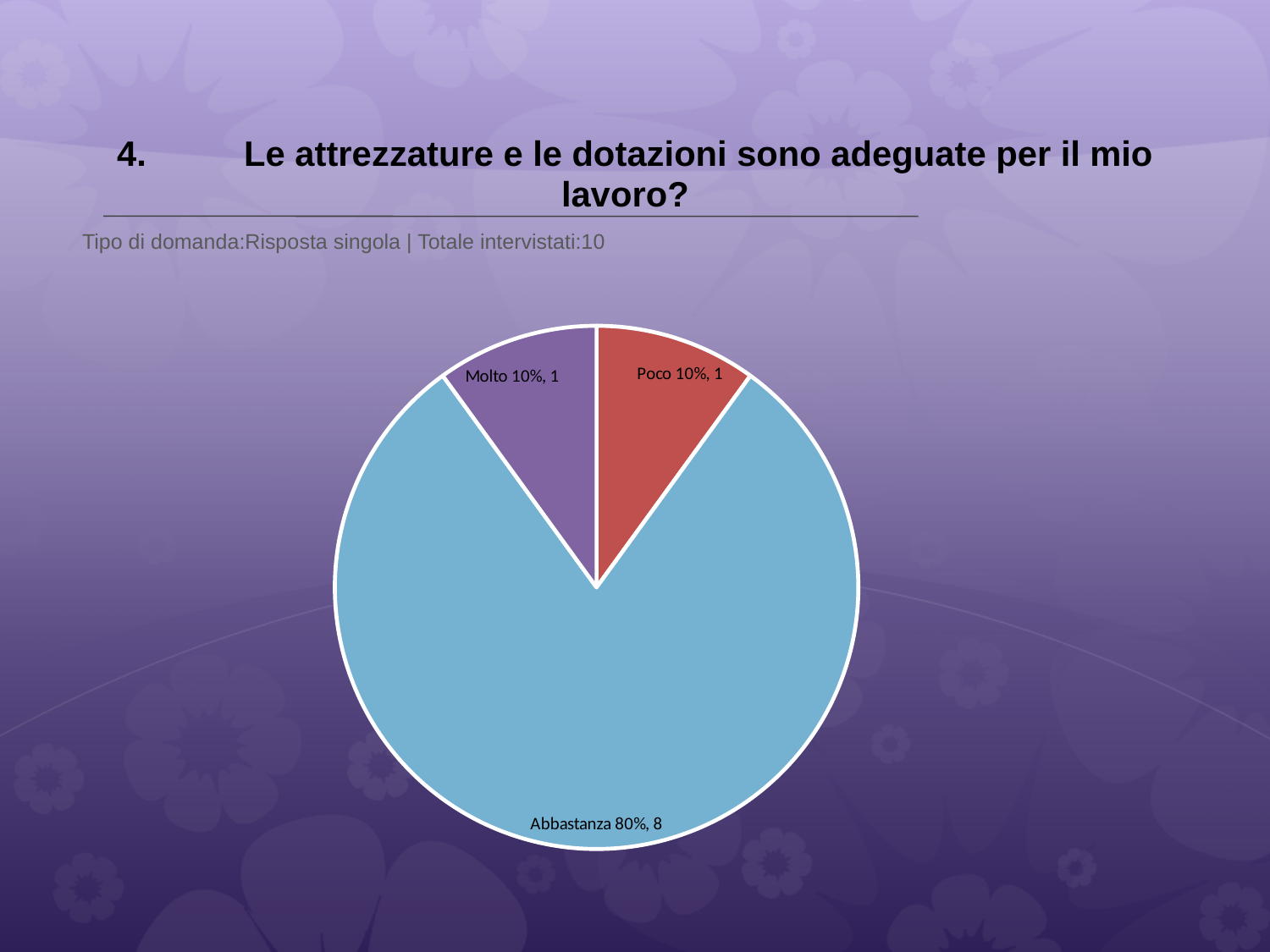
What is the total number of respondents across all slices? 10 What percentage share does the Molto slice have? 10% What colour is the Abbastanza slice? light blue How many slices does the pie chart have? 3 What percentage share does the Poco slice have? 10% What kind of chart is shown on the slide? pie chart What is the difference in respondent count between Abbastanza and Poco? 7 Which category has the largest slice of the pie? Abbastanza How many respondents answered Molto? 1 What percentage share does the Abbastanza slice have? 80% How many respondents answered Abbastanza? 8 Which is larger, the Abbastanza slice or the Molto slice? Abbastanza